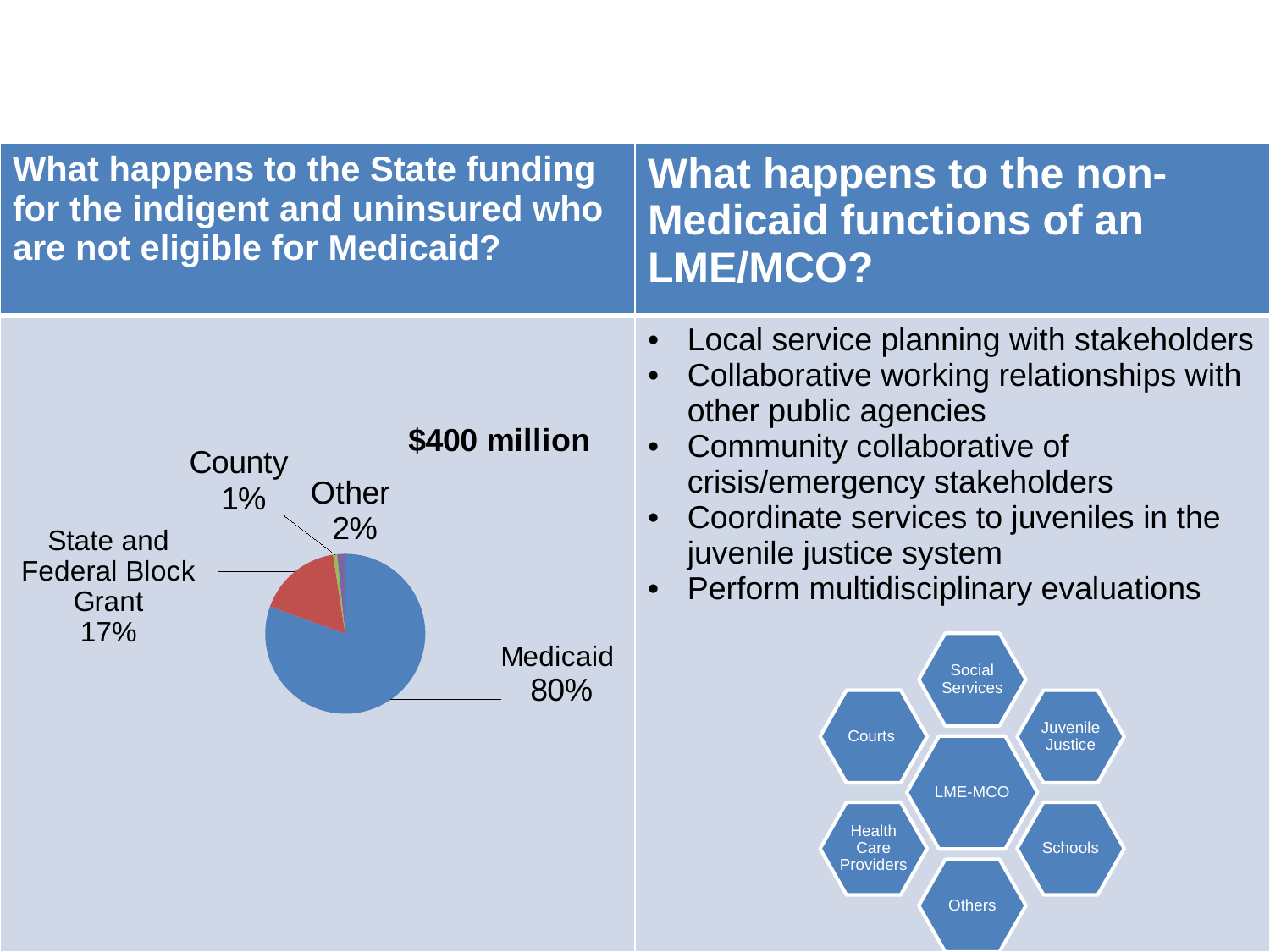
Which is larger in the pie chart, Other or County? Other How many slices does the pie chart have? 4 What is the difference in percentage points between the Medicaid slice and the State and Federal Block Grant slice? 63 What colour is the Medicaid slice of the pie chart? blue What total amount is labelled above the pie chart? $400 million What share of the pie chart does Other represent? 2% Which slice of the pie chart is the largest? Medicaid What share of the pie chart does County represent? 1% What share of the pie chart does State and Federal Block Grant represent? 17% Which slice of the pie chart is the smallest? County What kind of chart is shown on the left side of the slide? pie chart What share of the pie chart does Medicaid represent? 80%